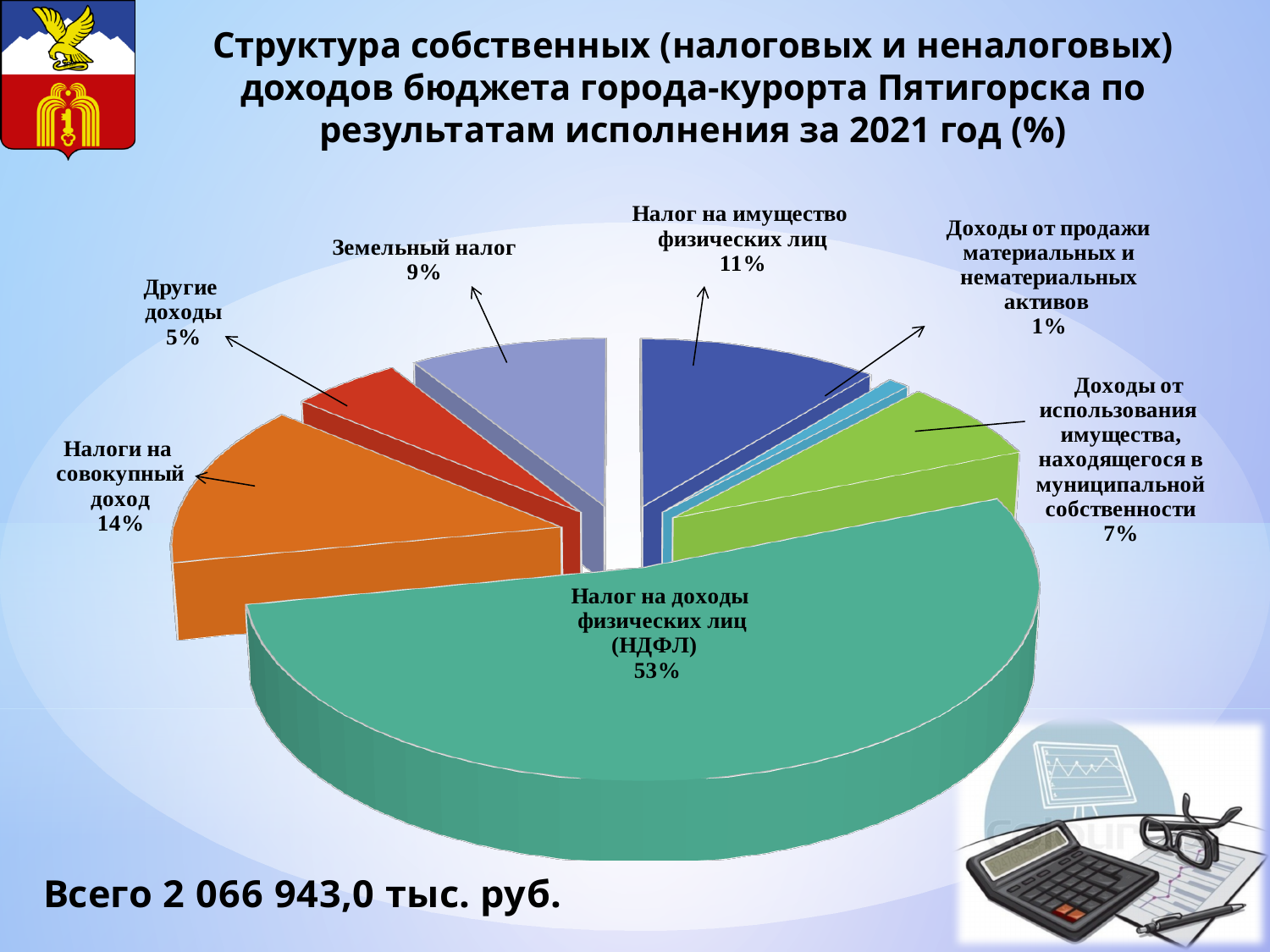
Which category has the largest share of the pie? Налог на доходы физических лиц (НДФЛ) How many slices does the pie chart have? 7 What kind of chart is shown on the slide? Pie chart What is the difference between the shares of "Налог на доходы физических лиц (НДФЛ)" and "Налоги на совокупный доход"? 39% What is the value shown for "Доходы от использования имущества, находящегося в муниципальной собственности"? 7% What is the value shown for "Земельный налог"? 9% Which is larger: the share of "Налоги на совокупный доход" or the share of "Земельный налог"? Налоги на совокупный доход Which category has the smallest share of the pie? Доходы от продажи материальных и нематериальных активов What total amount is stated below the chart? 2 066 943,0 тыс. руб. What is the difference between the shares of "Налог на имущество физических лиц" and "Другие доходы"? 6% What share of the pie does "Налог на доходы физических лиц (НДФЛ)" have? 53% What is the value shown for "Налоги на совокупный доход"? 14%